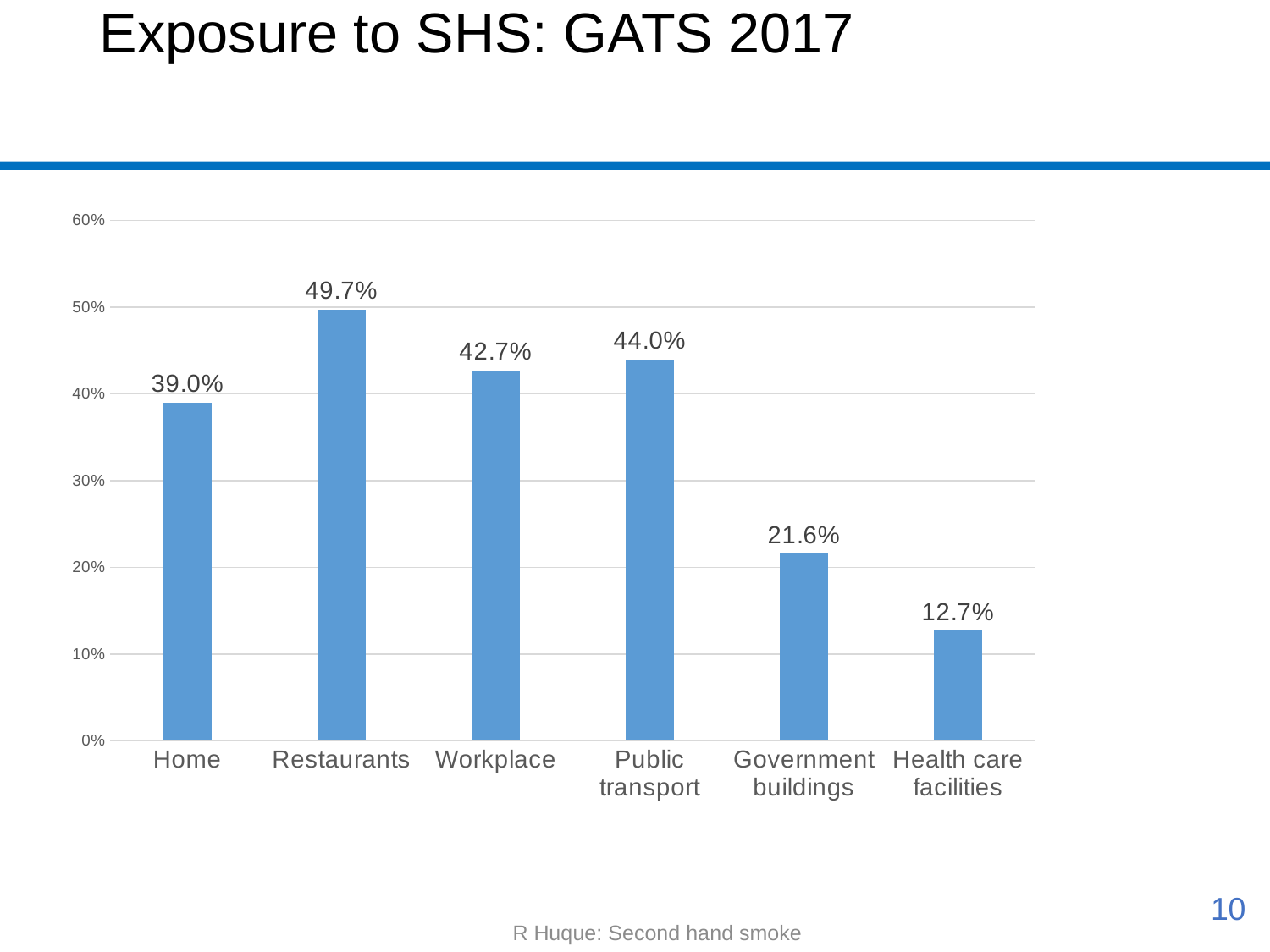
What is the value for Government buildings? 21.6% How many categories are shown on the x axis? 6 What is the value for Home? 39.0% Which category has the highest value? Restaurants What is the difference between the values for Restaurants and Home? 10.7% Which category has the lowest value? Health care facilities What is the value for Restaurants? 49.7% What kind of chart is shown on the slide? Bar chart Which is larger, the value for Workplace or the value for Government buildings? Workplace Is the value for Public transport greater or less than 40%? greater What is the value for Health care facilities? 12.7% What is the difference between the values for Public transport and Workplace? 1.3%